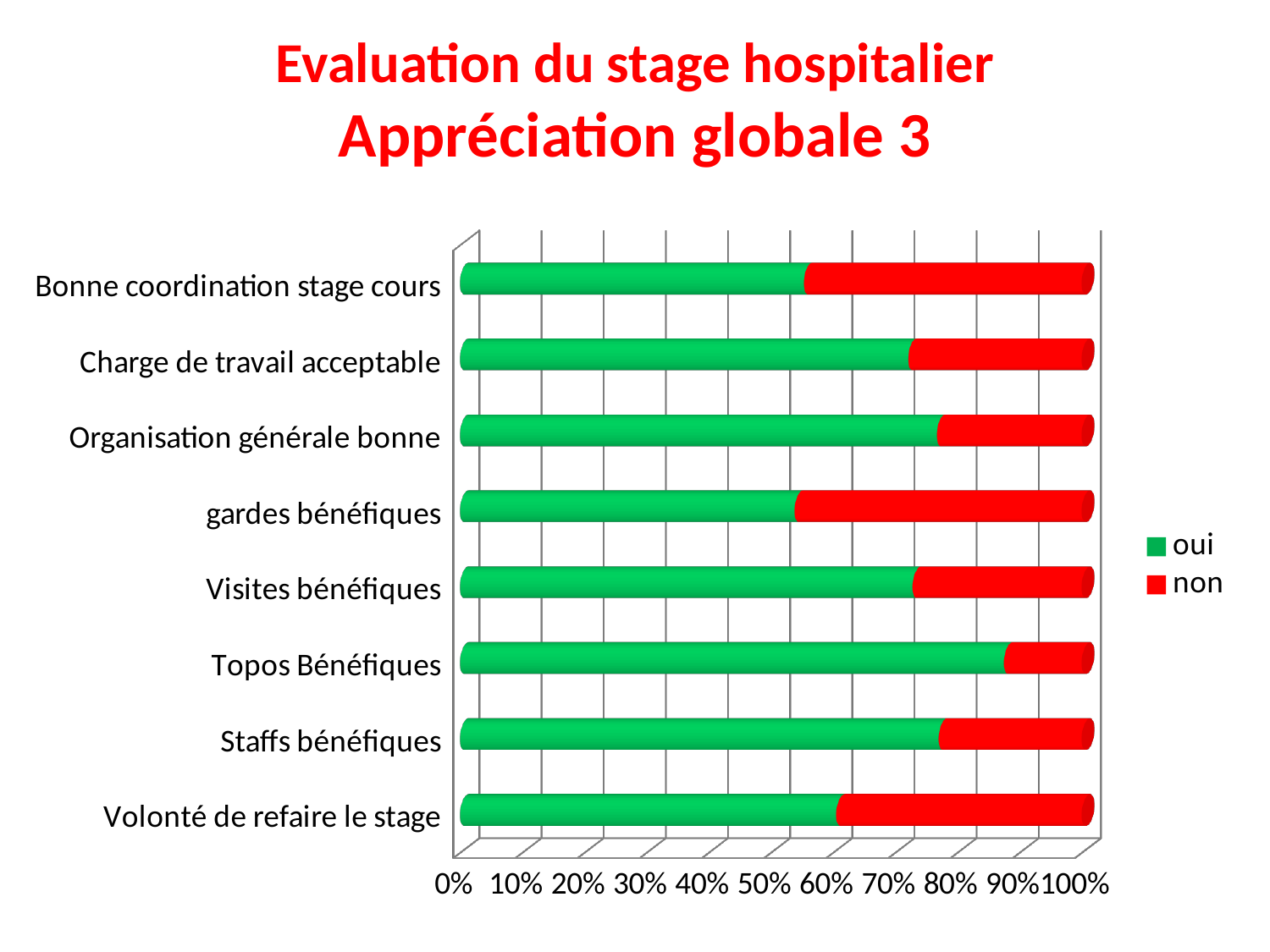
Which has a larger 'non' share: gardes bénéfiques or Staffs bénéfiques? gardes bénéfiques Is the 'oui' value for Volonté de refaire le stage greater or less than 50%? greater Which colour represents the 'non' series in the legend? red Is the 'oui' value for Topos Bénéfiques greater or less than 80%? greater Is the 'oui' value for gardes bénéfiques greater or less than 60%? less Which has a larger 'oui' share: Topos Bénéfiques or Volonté de refaire le stage? Topos Bénéfiques How many series does the legend list? 2 Which category has the largest 'oui' share? Topos Bénéfiques What kind of chart is shown on the slide? bar chart How many categories are plotted on the chart? 8